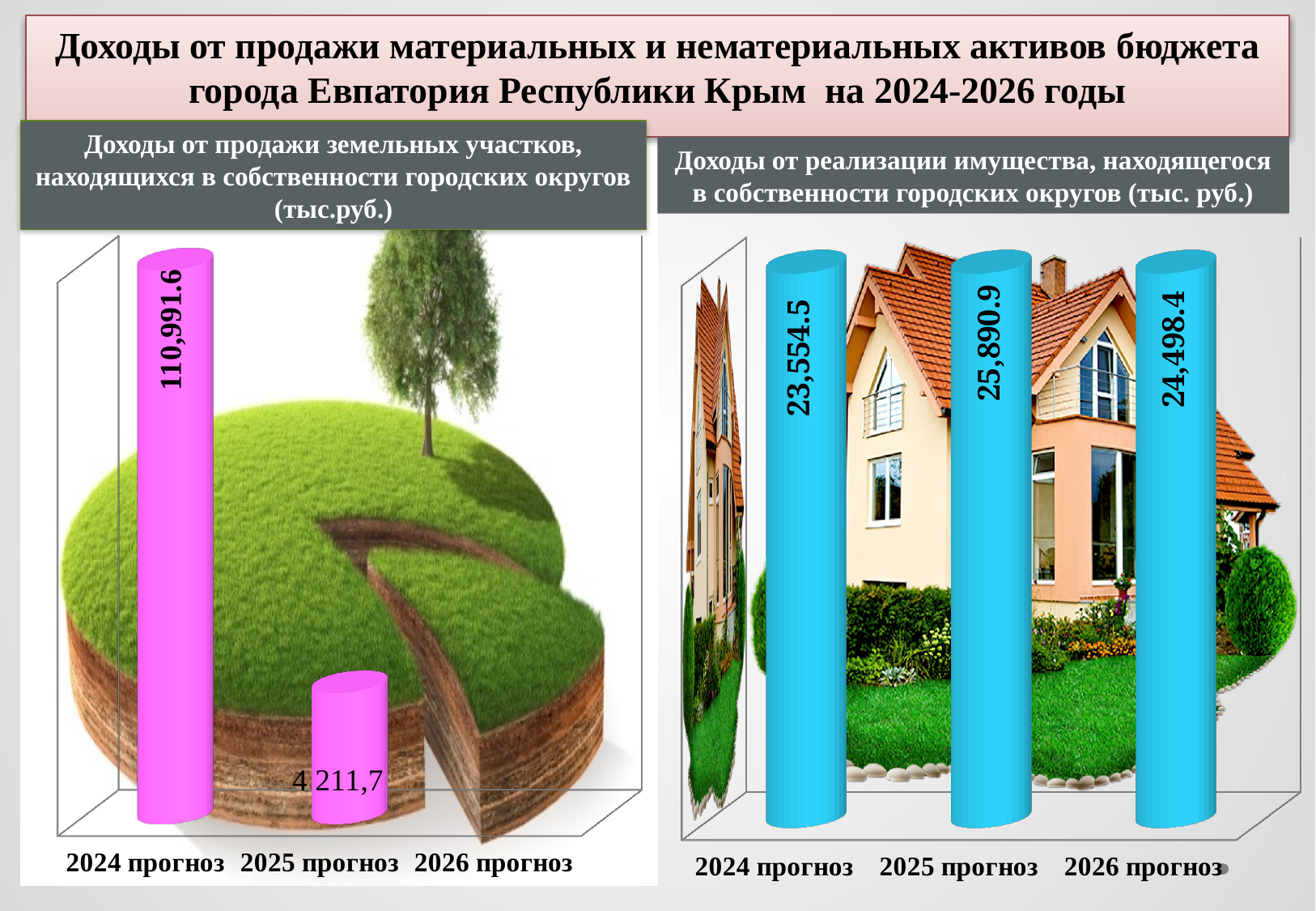
In the right chart (Доходы от реализации имущества), what is the difference between the 2025 прогноз and 2024 прогноз values? 2,336.4 In the left chart (Доходы от продажи земельных участков), what is the difference between the 2024 прогноз and 2025 прогноз values? 106,779.9 In the right chart (Доходы от реализации имущества), which is larger: the value for 2026 прогноз or the value for 2024 прогноз? 2026 прогноз In the right chart (Доходы от реализации имущества), which year has the highest value? 2025 прогноз In the right chart (Доходы от реализации имущества), which year has the lowest value? 2024 прогноз How many year categories are labelled on the x axis of the right chart (Доходы от реализации имущества)? 3 In the right chart (Доходы от реализации имущества), what is the value for 2025 прогноз? 25,890.9 In the left chart (Доходы от продажи земельных участков), what is the value for 2025 прогноз? 4 211,7 In the left chart (Доходы от продажи земельных участков), what is the value for 2024 прогноз? 110,991.6 What kind of chart is the right chart (Доходы от реализации имущества)? Bar chart In the right chart (Доходы от реализации имущества), what is the value for 2024 прогноз? 23,554.5 In the right chart (Доходы от реализации имущества), what is the value for 2026 прогноз? 24,498.4